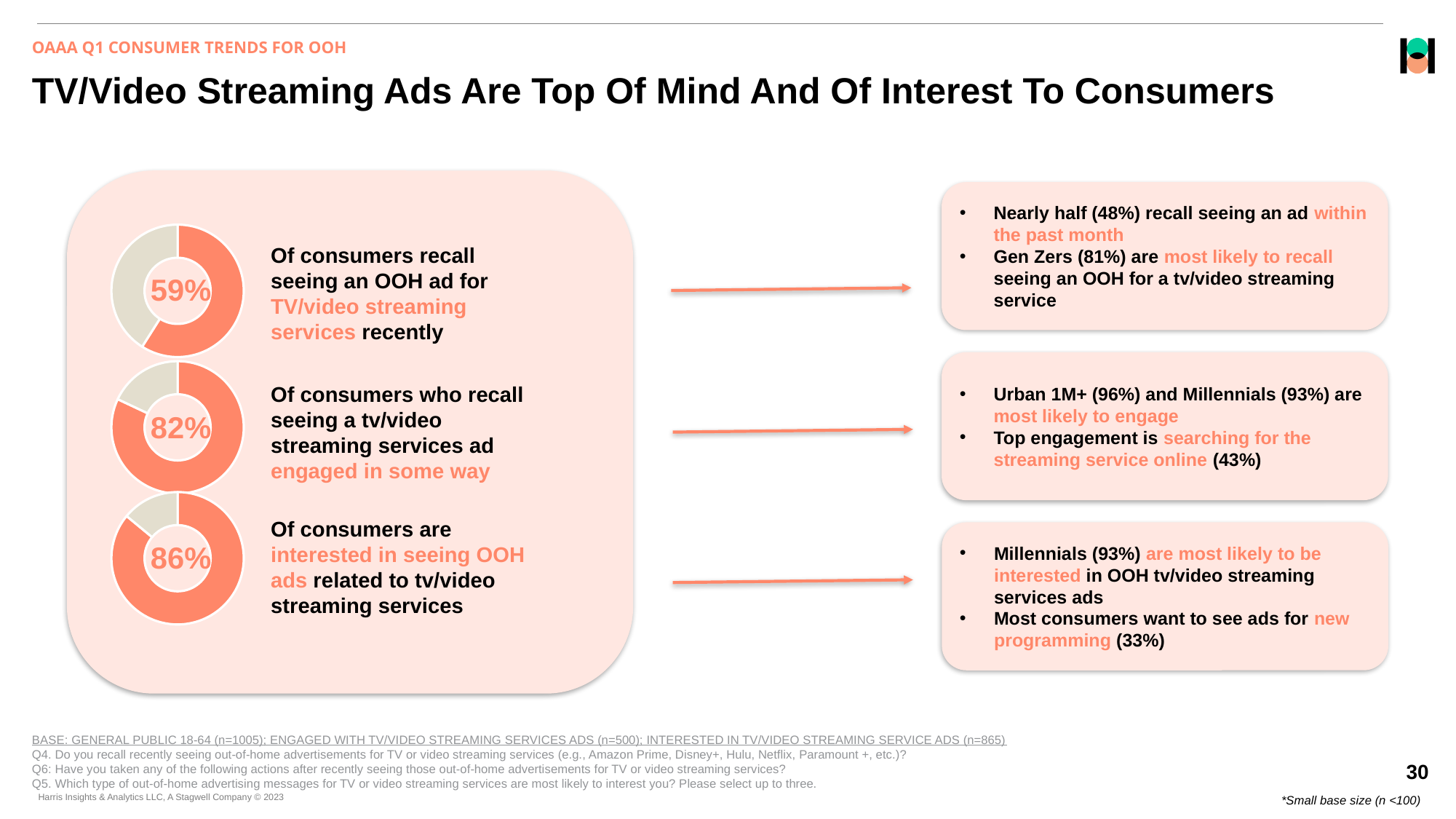
How many donut charts are shown on the slide? 3 What is the difference between the percentage in the middle donut chart (82%) and the top donut chart (59%)? 23 percentage points What is the difference between the percentage in the bottom donut chart (86%) and the top donut chart (59%)? 27 percentage points Which of the three donut charts shows the lowest percentage? The top one (recall seeing an OOH ad), 59% What kind of charts are used on the left side of the slide to show the three percentages? Donut (pie) charts Which is larger: the percentage in the middle donut chart (engaged in some way) or the bottom donut chart (interested in seeing OOH ads)? The bottom donut chart (86%) What percentage is shown in the top donut chart, for consumers who recall seeing an OOH ad for TV/video streaming services recently? 59% Which of the three donut charts shows the highest percentage? The bottom one (interested in seeing OOH ads), 86% What colour is used for the filled portion of the donut charts? Orange (salmon) In the top donut chart, is the filled (orange) share greater or less than 50%? greater What percentage is shown in the middle donut chart, for consumers who recall seeing a TV/video streaming services ad and engaged in some way? 82% What percentage is shown in the bottom donut chart, for consumers interested in seeing OOH ads related to TV/video streaming services? 86%